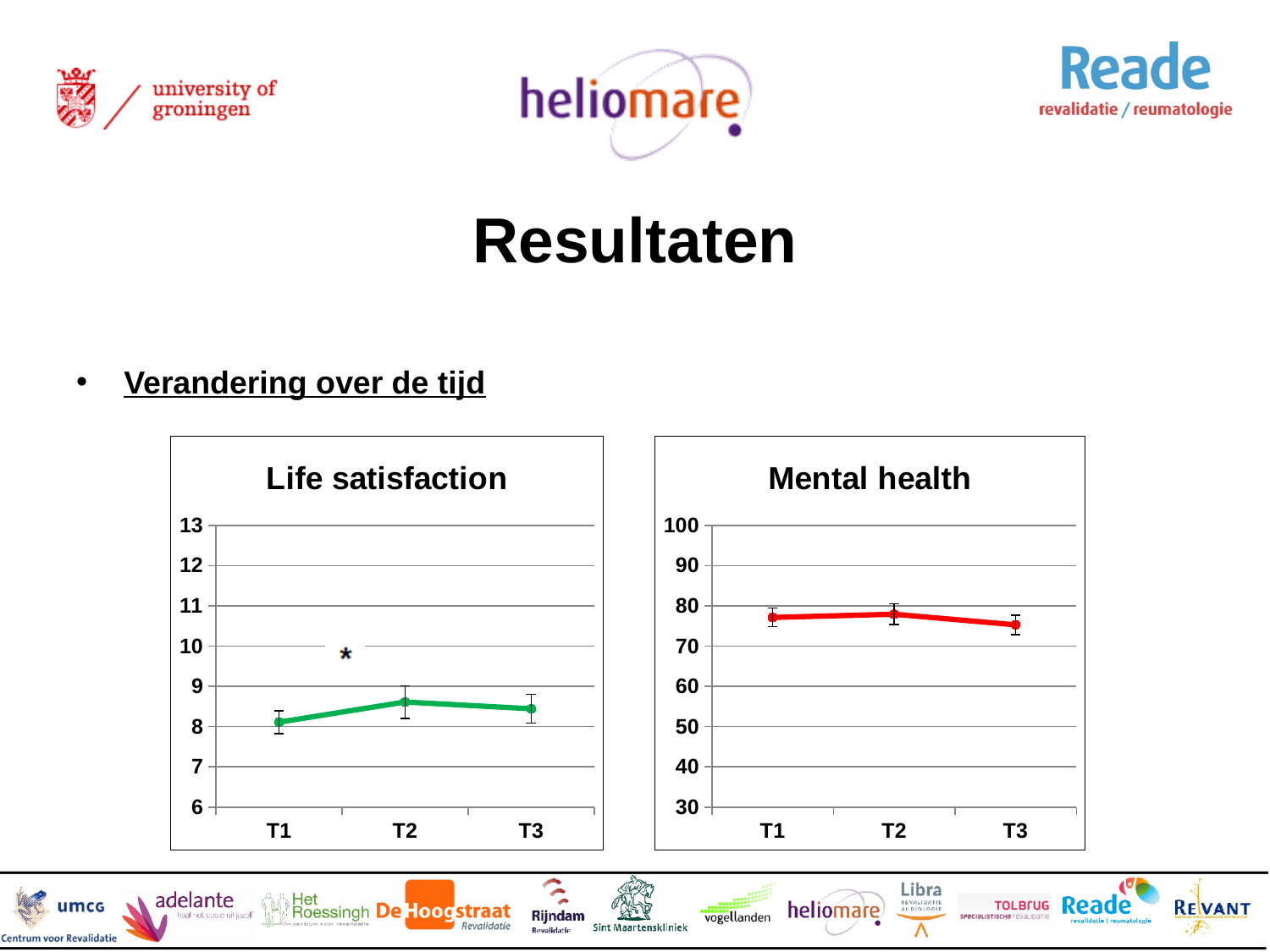
What colour is the line in the Mental health chart? red In the Life satisfaction chart, is the value for T2 greater or less than 9? less In the Life satisfaction chart, does the value rise or fall from T1 to T2? rise In the Mental health chart, is the value for T3 greater or less than 80? less In the Life satisfaction chart, which time point has the lowest value? T1 In the Life satisfaction chart, is the value for T3 greater or less than 7? greater In the Mental health chart, does the value rise or fall from T2 to T3? fall What kind of chart is the Life satisfaction chart? line chart How many time points are plotted on the Mental health chart? 3 In the Mental health chart, which time point has the lowest value? T3 In the Life satisfaction chart, which time point has the highest value? T2